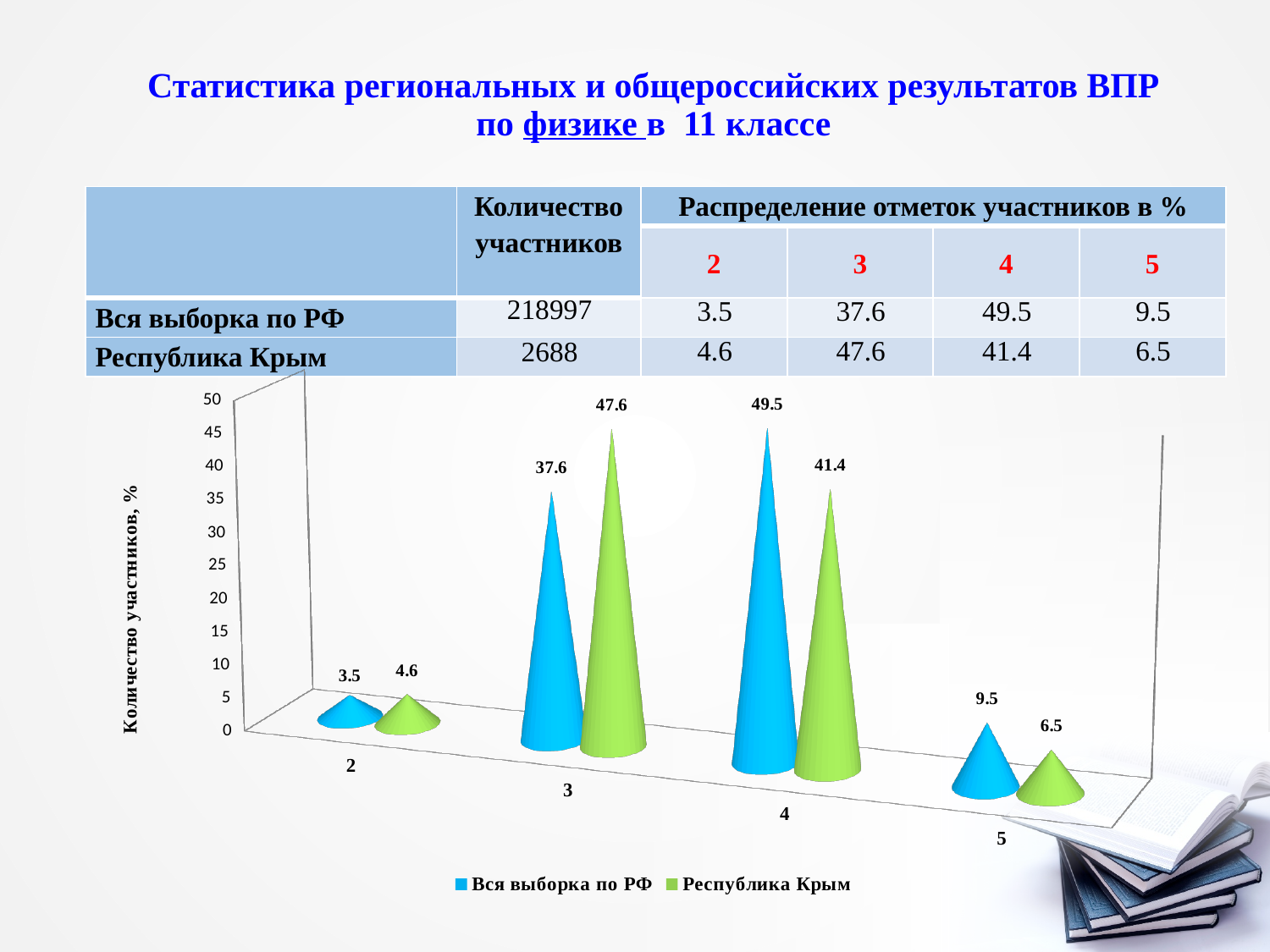
Which series has the larger value at grade 4? Вся выборка по РФ What is the value for "Республика Крым" at grade 2? 4.6 What is the difference between "Республика Крым" and "Вся выборка по РФ" at grade 3? 10 What is the value for "Республика Крым" at grade 4? 41.4 Which grade has the lowest value for "Республика Крым"? 2 Which series has the larger value at grade 2? Республика Крым What is the label of the vertical axis? Количество участников, % Which grade has the highest value for "Вся выборка по РФ"? 4 What is the value for "Вся выборка по РФ" at grade 3? 37.6 How many grade categories are shown on the x axis? 4 How many series does the legend list? 2 What is the difference between "Вся выборка по РФ" and "Республика Крым" at grade 5? 3